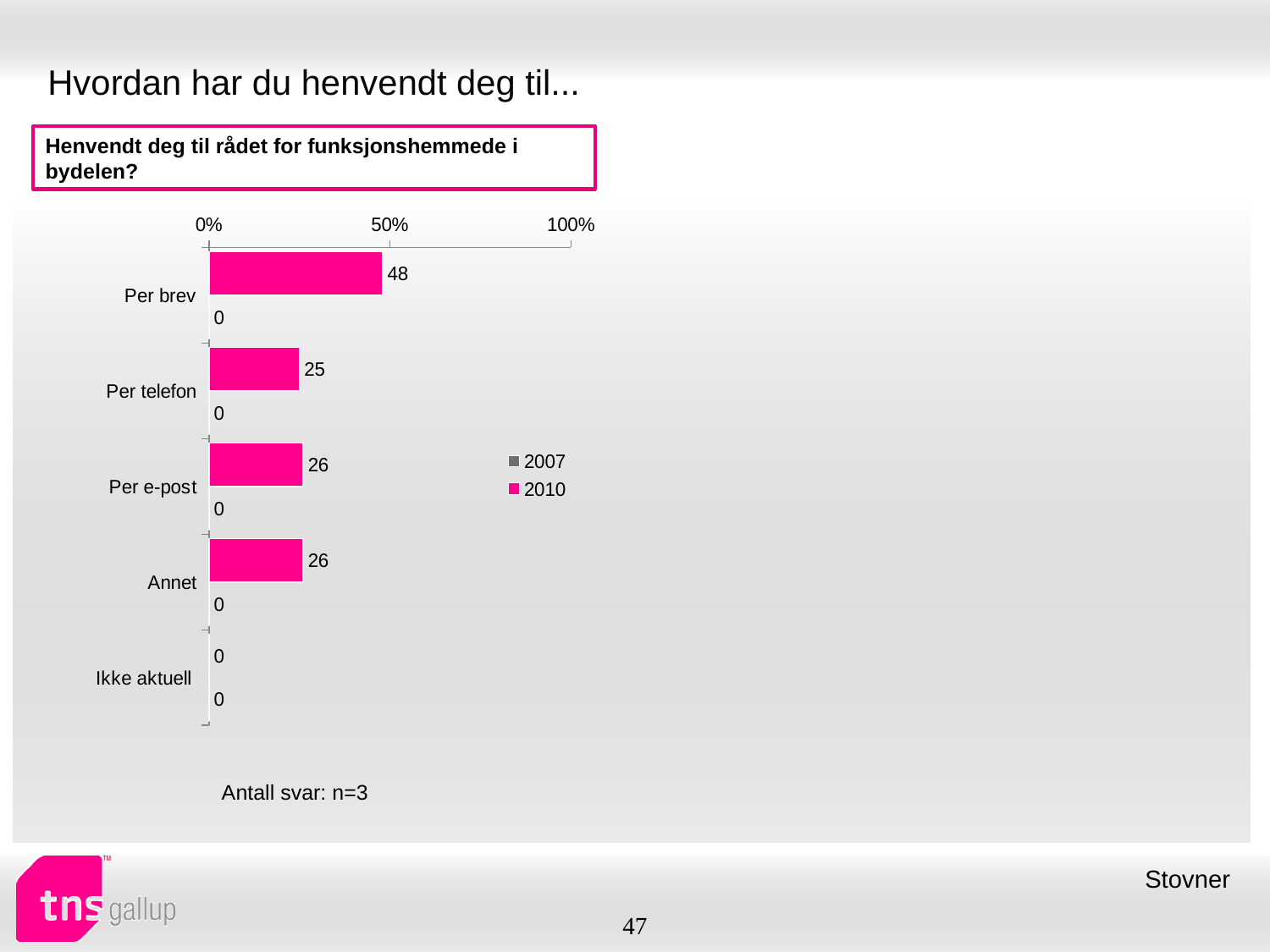
Which category has the lowest 2010 value? Ikke aktuell How many categories are shown on the chart? 5 What is the difference between the 2010 values for Per brev and Per telefon? 23 What is the 2010 value for Per e-post? 26 Which category has the highest 2010 value? Per brev What is the 2007 value for Annet? 0 Which is larger, the 2010 value for Per brev or the 2010 value for Annet? Per brev What is the 2010 value for Per brev? 48 What is the 2010 value for Per telefon? 25 How many series does the legend list? 2 Is the 2010 value for Per brev greater or less than 50%? less What type of chart is shown on the slide? bar chart